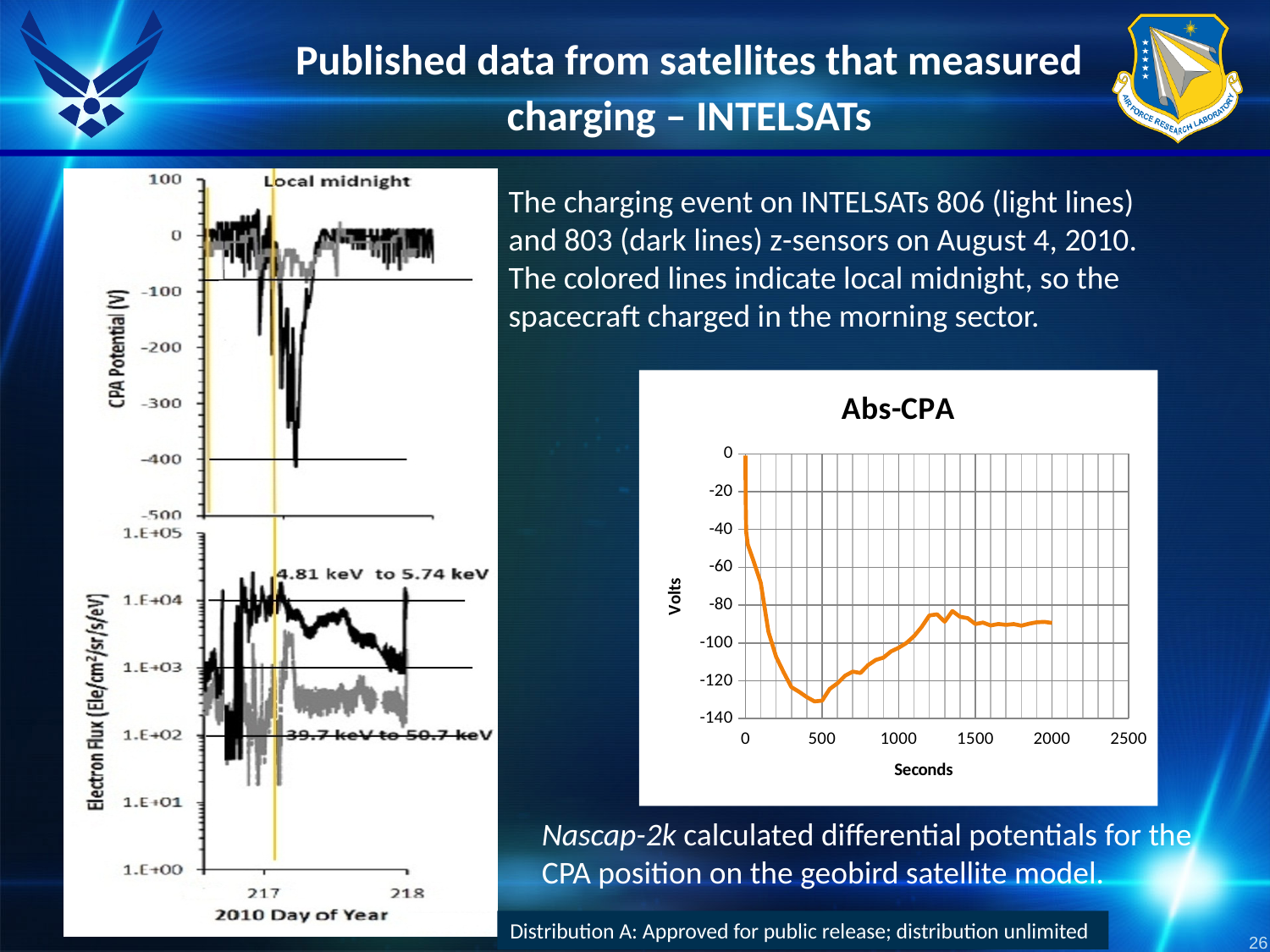
On the Abs-CPA chart, is the lowest point of the line reached before or after 1000 seconds? before How many lines are plotted on the Abs-CPA chart? 1 What is the x-axis label of the Abs-CPA chart? Seconds On the Abs-CPA chart, do the values rise or fall between 500 and 1500 seconds? rise On the Abs-CPA chart, is the value at 500 seconds greater or less than -120? less What kind of chart is the Abs-CPA chart? line chart On the Abs-CPA chart, is the value at 2000 seconds greater or less than -100? greater In the Electron Flux panel of the left chart, which energy range shows the higher flux, 4.81 keV to 5.74 keV or 39.7 keV to 50.7 keV? 4.81 keV to 5.74 keV What is the x-axis label of the chart on the left side of the slide? 2010 Day of Year In the CPA Potential panel of the left chart, is the lowest value of the dark line greater or less than -300? less On the Abs-CPA chart, do the values rise or fall between 0 and 500 seconds? fall